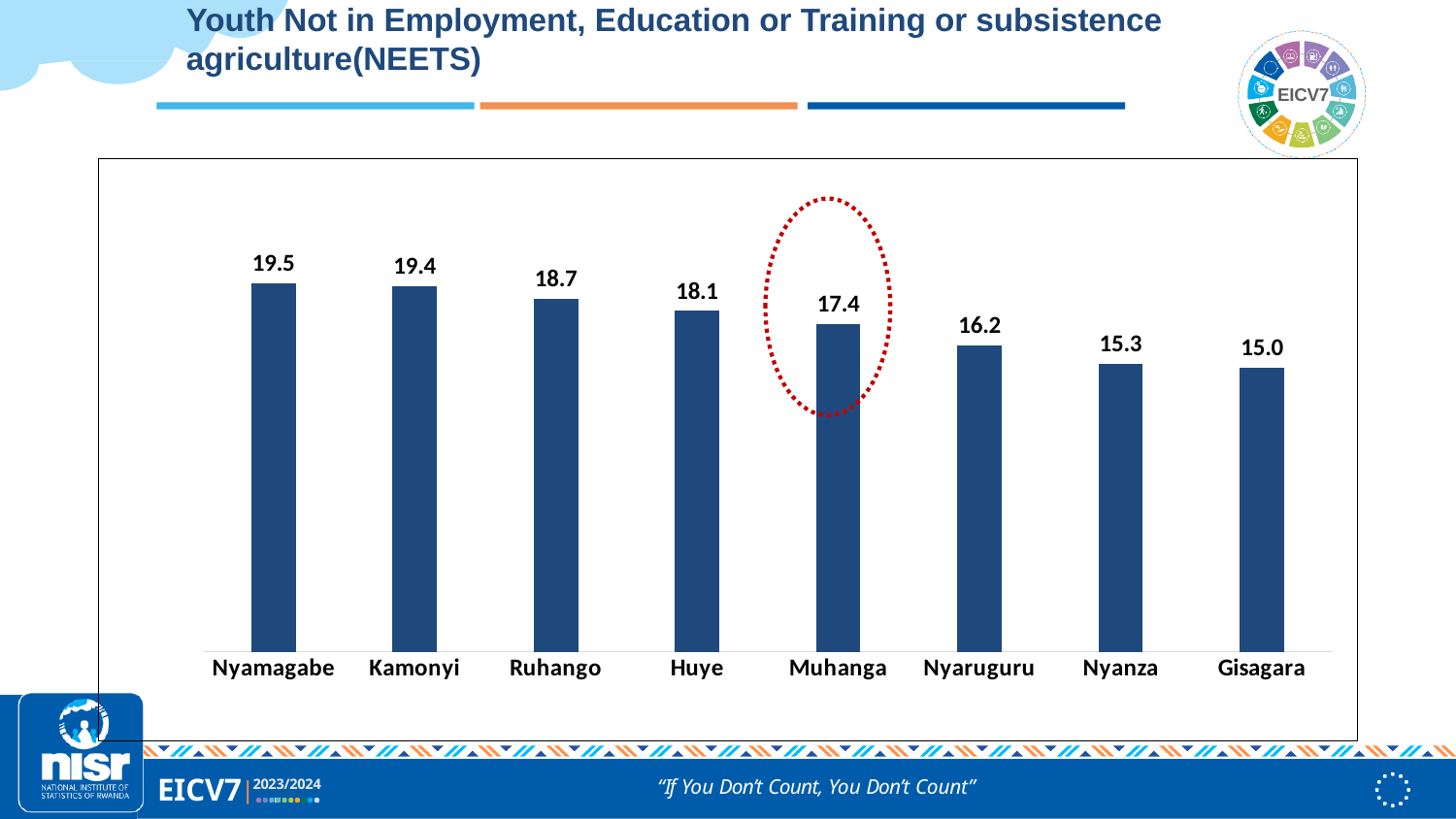
Which district has the lowest value? Gisagara What kind of chart is shown on the slide? Bar chart Which district's bar is highlighted with a red dotted circle? Muhanga Which district has the highest value? Nyamagabe How many districts are shown in the chart? 8 What is the difference between the values for Huye and Muhanga? 0.7 Which is larger, the value for Ruhango or the value for Nyaruguru? Ruhango What is the value for Nyamagabe? 19.5 What is the difference between the values for Nyamagabe and Gisagara? 4.5 What is the value for Gisagara? 15.0 What is the value for Muhanga? 17.4 Do the values rise or fall from left to right across the districts? Fall